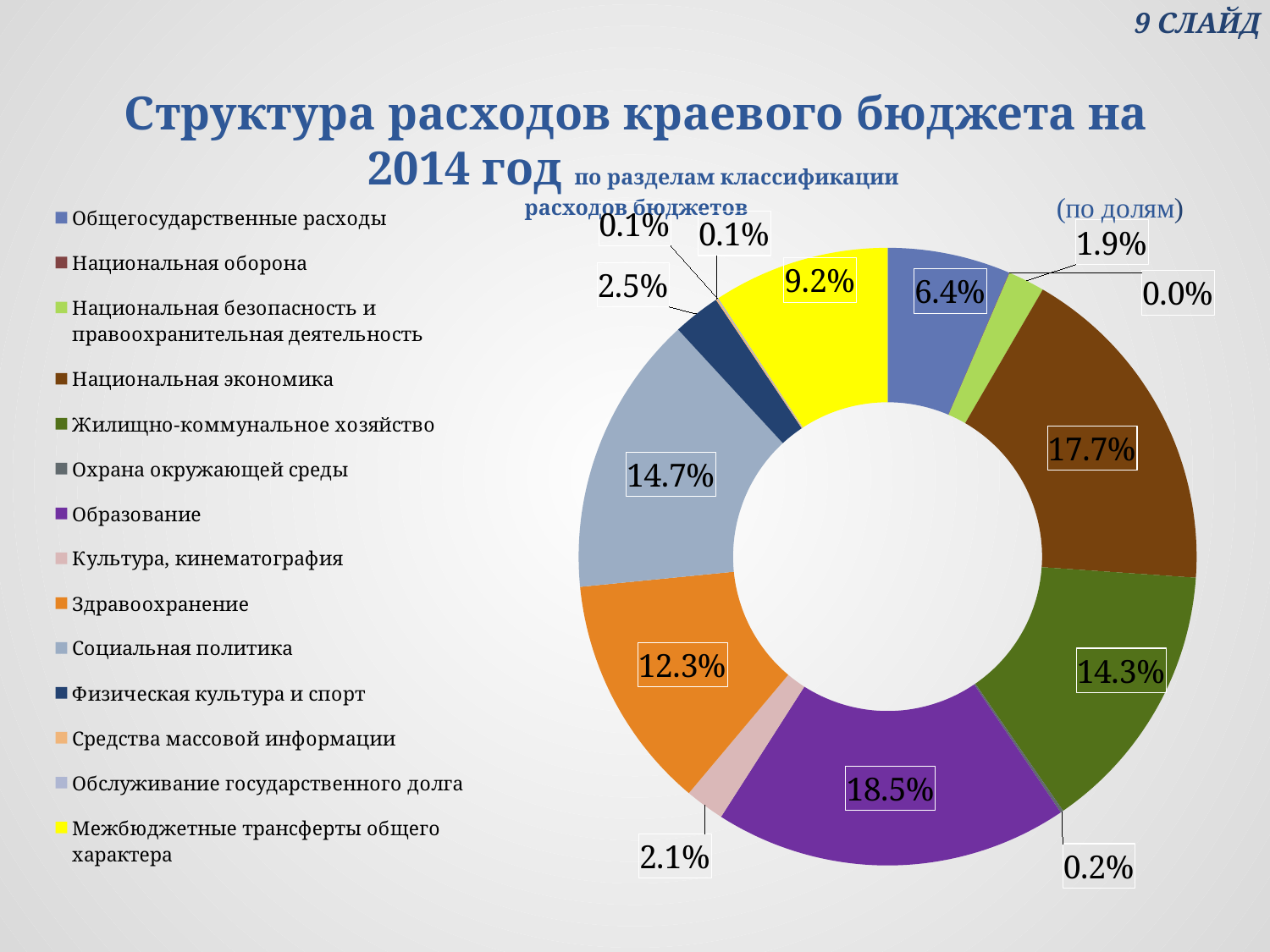
What is the title of the slide? Структура расходов краевого бюджета на 2014 год Which has a larger share: Жилищно-коммунальное хозяйство or Здравоохранение? Жилищно-коммунальное хозяйство What share is shown for Межбюджетные трансферты общего характера? 9.2% What share is shown for Здравоохранение? 12.3% What is the difference in percentage points between the shares for Образование and Национальная экономика? 0.8 How many categories does the legend list? 14 What type of chart is shown on the slide? Doughnut (pie) chart Which category has the largest share of expenditure? Образование What share is shown for Социальная политика? 14.7% Which category has the smallest share of expenditure? Национальная оборона What share of the regional budget expenditure goes to Образование? 18.5% What share is shown for Национальная экономика? 17.7%